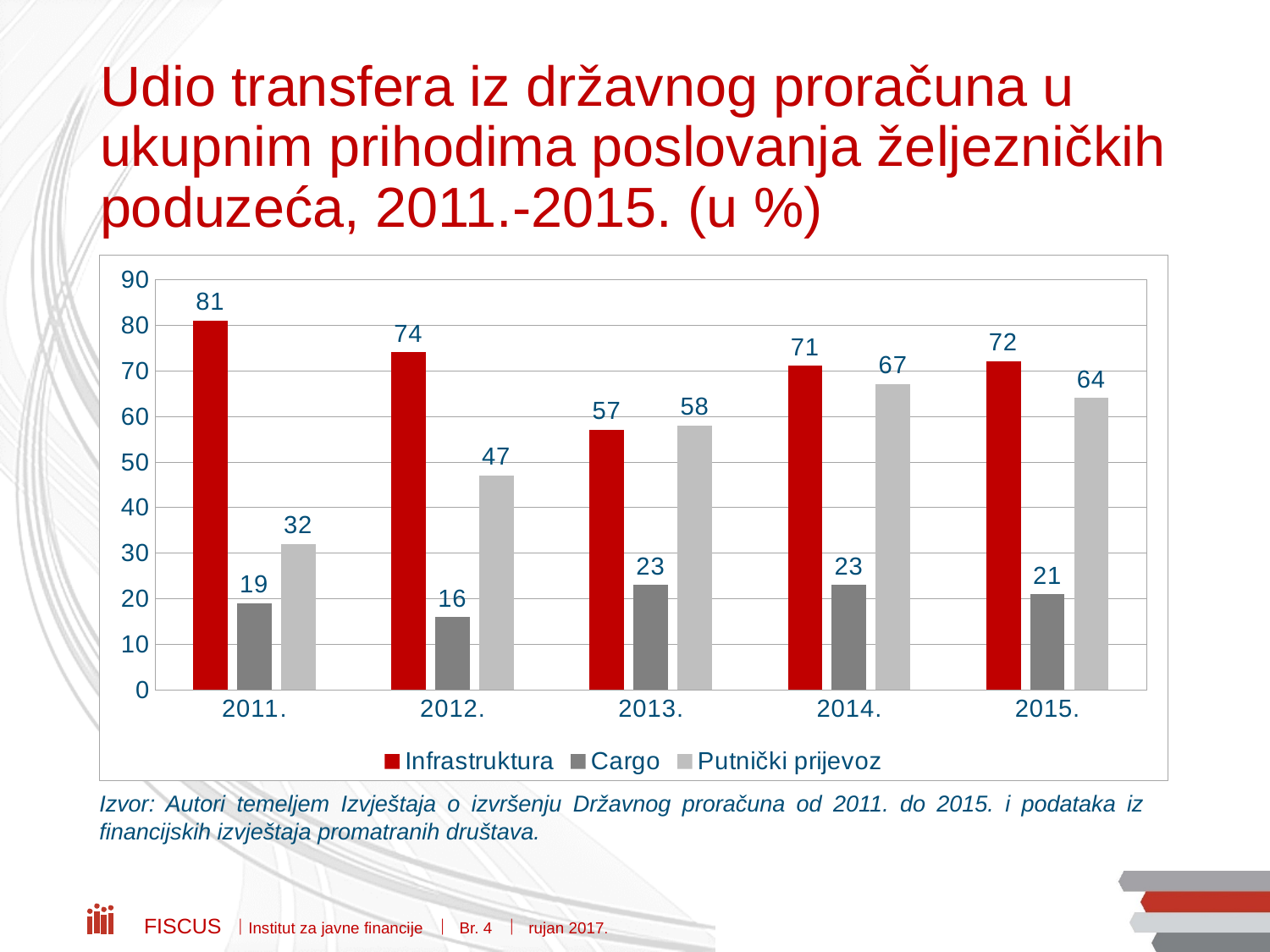
Which colour represents Infrastruktura in the chart? red What is the value for Infrastruktura in 2011.? 81 What kind of chart is shown on the slide? bar chart Does the Putnički prijevoz value rise or fall from 2011. to 2014.? rise In which year is the Putnički prijevoz value lowest? 2011. Which is larger in 2013., Infrastruktura or Putnički prijevoz? Putnički prijevoz How many years are shown on the x axis? 5 How many series does the legend list? 3 In which year is the Infrastruktura value highest? 2011. What is the value for Cargo in 2012.? 16 What is the difference between the Infrastruktura and Putnički prijevoz values in 2015.? 8 What is the value for Putnički prijevoz in 2013.? 58